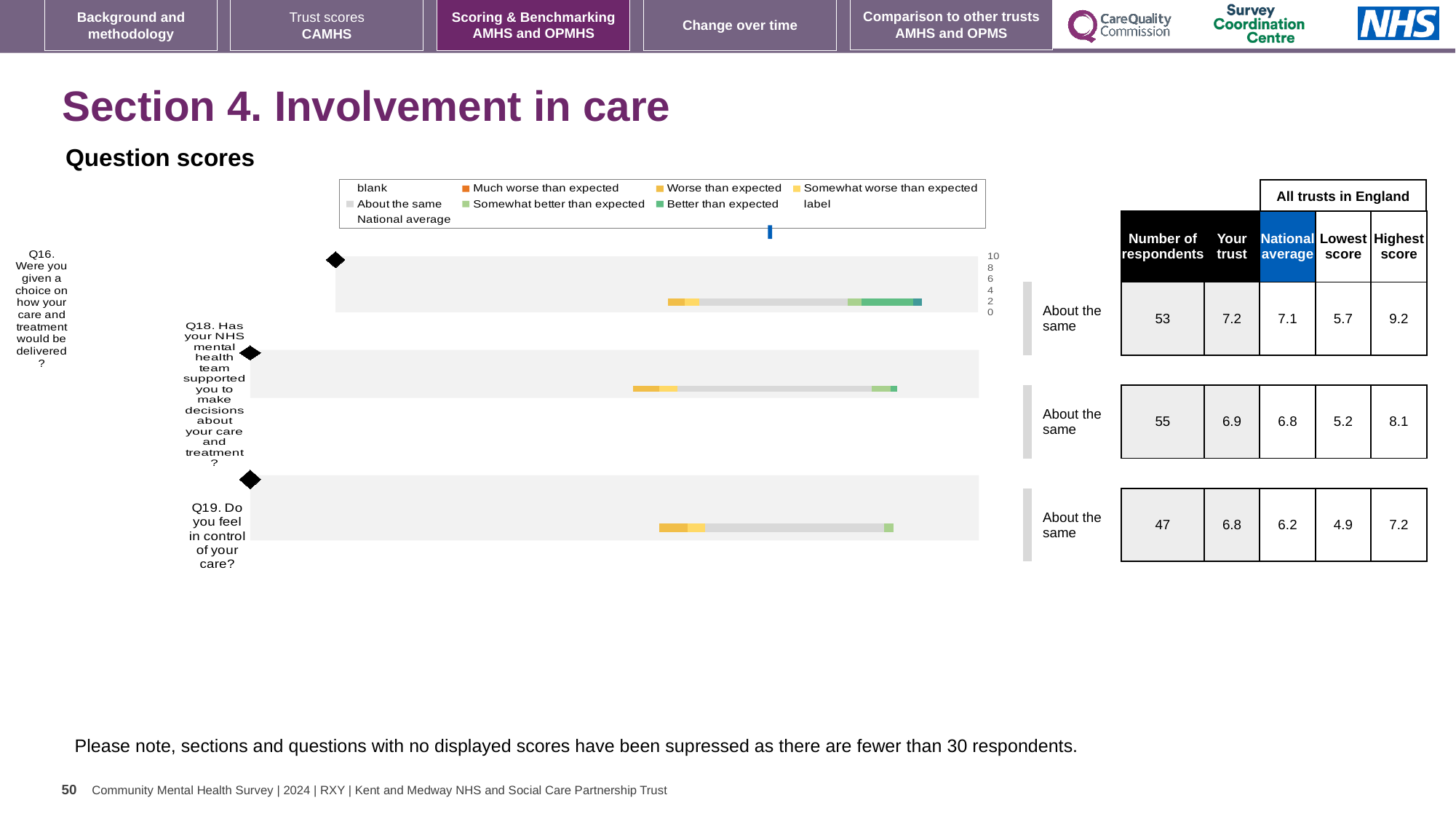
In the table beside the charts, what is the 'Your trust' score for Q16? 7.2 In the legend, what colour is used for 'About the same'? grey What kind of chart is used to show the question scores on this slide? bar chart In the table beside the charts, what is the national average for Q19? 6.2 How many questions (Q16, Q18, Q19) have a bar chart plotted on this slide? 3 In the table beside the charts, which question has the highest 'Your trust' score? Q16 What benchmark category is shown next to the chart for Q19? About the same How many entries does the legend above the question score charts list? 9 In the table beside the charts, what is the number of respondents for Q18? 55 What benchmark category is shown next to the chart for Q16? About the same In the legend, what colour is used for 'Much worse than expected'? orange In the table beside the charts, what is the difference between the 'Your trust' score and the national average for Q19? 0.6